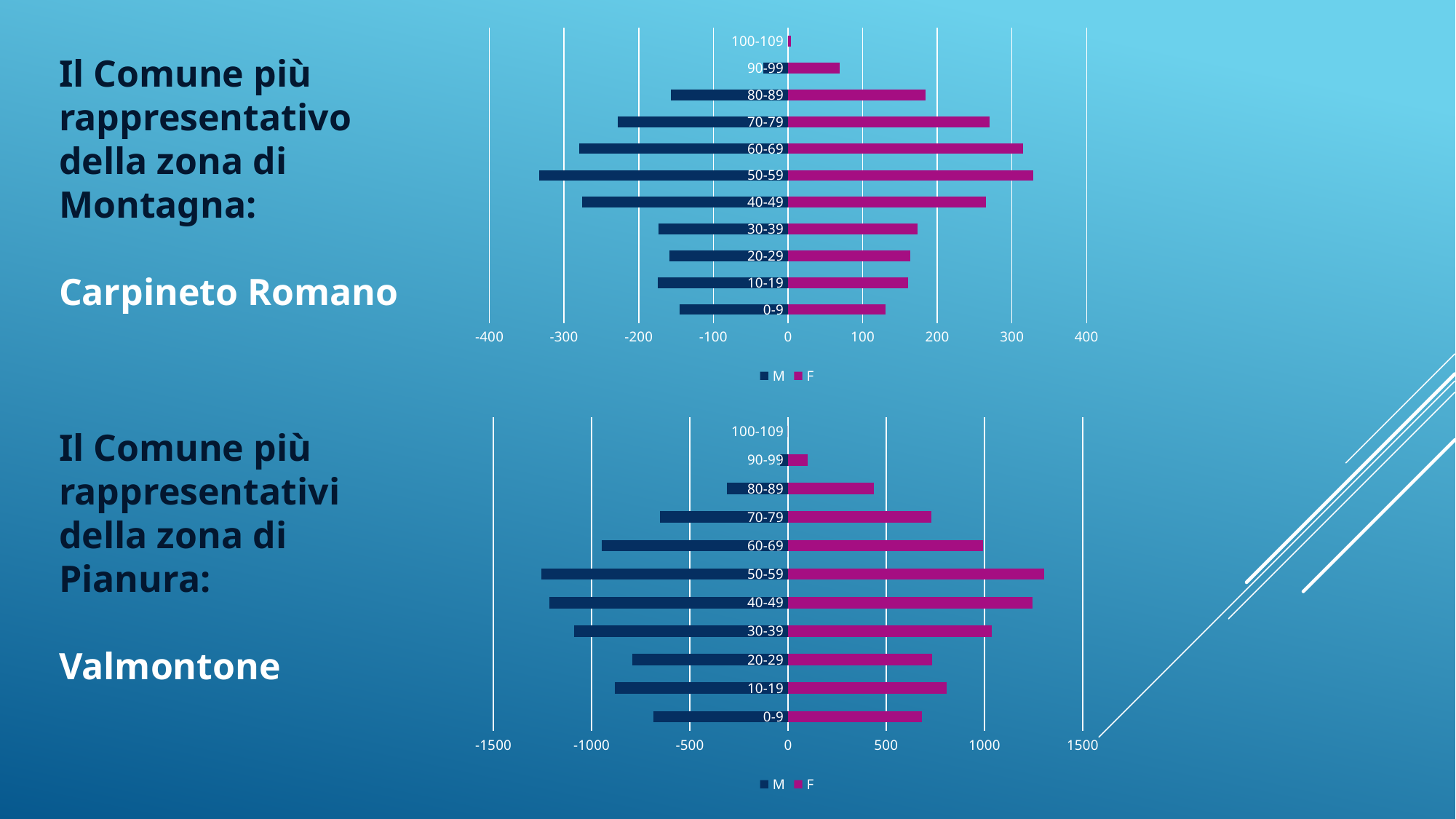
In the bottom chart (Valmontone), is the F value for 50-59 greater or less than 1000? greater In the top chart (Carpineto Romano), is the F value for 50-59 greater or less than 300? greater In the top chart (Carpineto Romano), is the F value for 90-99 greater or less than 100? less How many age-group categories does the bottom chart (Valmontone) show? 11 In the bottom chart (Valmontone), which is larger: the F value for 10-19 or the F value for 0-9? 10-19 How many series does the legend of the top chart (Carpineto Romano) list? 2 What kind of chart is the top chart (Carpineto Romano)? bar chart In the top chart (Carpineto Romano), which is larger: the F value for 70-79 or the F value for 30-39? 70-79 In the top chart (Carpineto Romano), which age group has the shortest F bar? 100-109 In the top chart (Carpineto Romano), which age group has the longest M bar? 50-59 What are the two legend entries shown under the bottom chart (Valmontone)? M and F